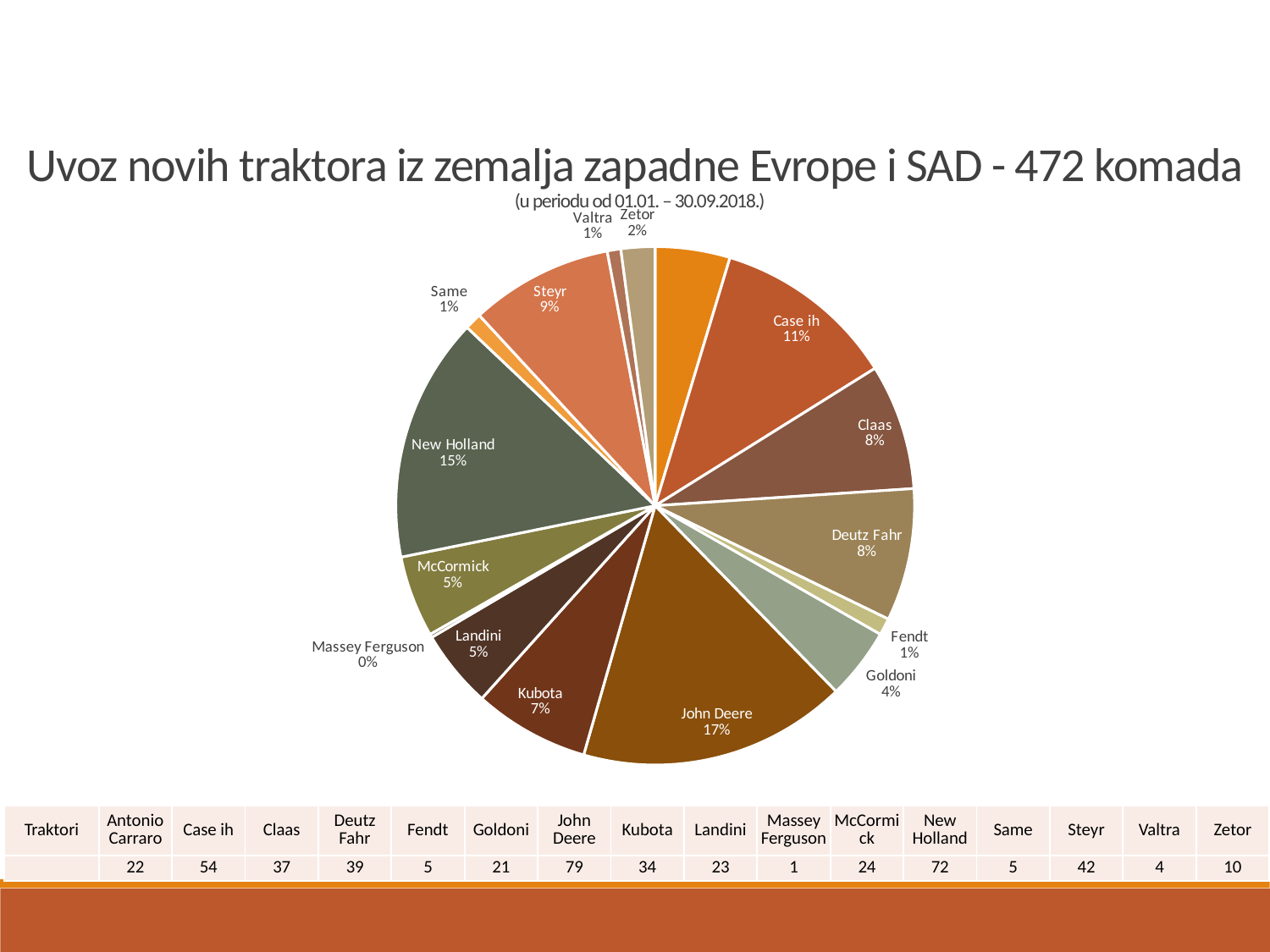
According to the data table, how many tractors were imported for Steyr? 42 What is the total number of tractors stated in the chart title? 472 What kind of chart is shown on the slide? pie chart Which has a larger value in the data table, Claas or Deutz Fahr? Deutz Fahr Which brand has the largest slice of the pie? John Deere What is the difference between the New Holland and Steyr values in the data table? 30 How many tractor brands are listed in the data table? 16 What share of the pie does New Holland account for? 15% According to the data table, how many tractors were imported for Case ih? 54 What period does the subtitle say the data covers? 01.01. – 30.09.2018. What share of the pie does John Deere account for? 17% Which brand has the smallest value in the data table? Massey Ferguson